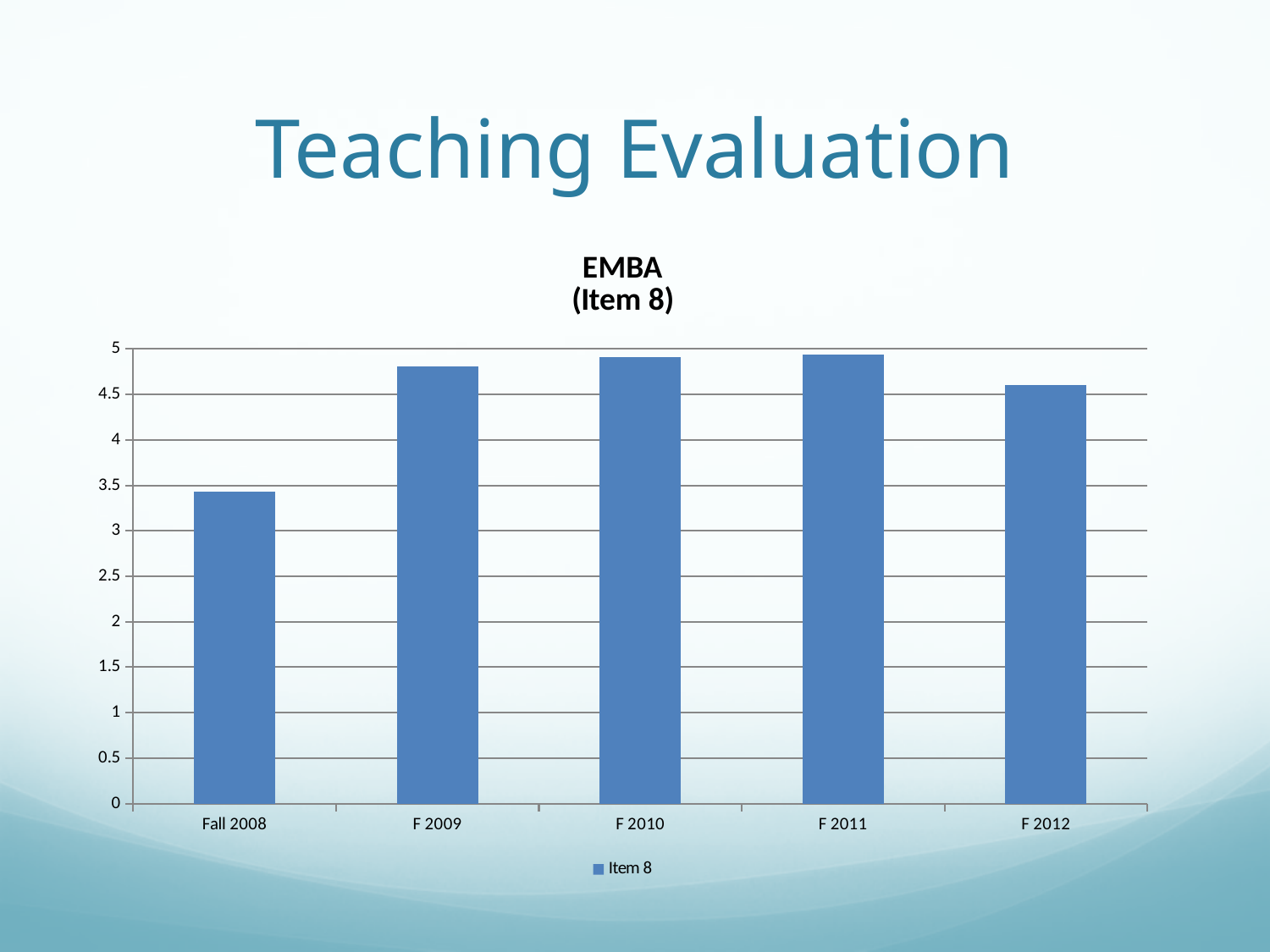
Is the value for Fall 2008 greater or less than 4? less What is the title of the chart? EMBA (Item 8) Does the value rise or fall from Fall 2008 to F 2009? rise Which is larger, the value for Fall 2008 or the value for F 2012? F 2012 Is the value for F 2009 greater or less than 4.5? greater How many series does the legend list? 1 Which is larger, the value for F 2010 or the value for F 2012? F 2010 What kind of chart is shown on the slide? Bar chart Is the value for F 2012 greater or less than 4.5? greater How many categories are shown on the x axis of the chart? 5 Which category has the lowest value? Fall 2008 What series name appears in the legend? Item 8